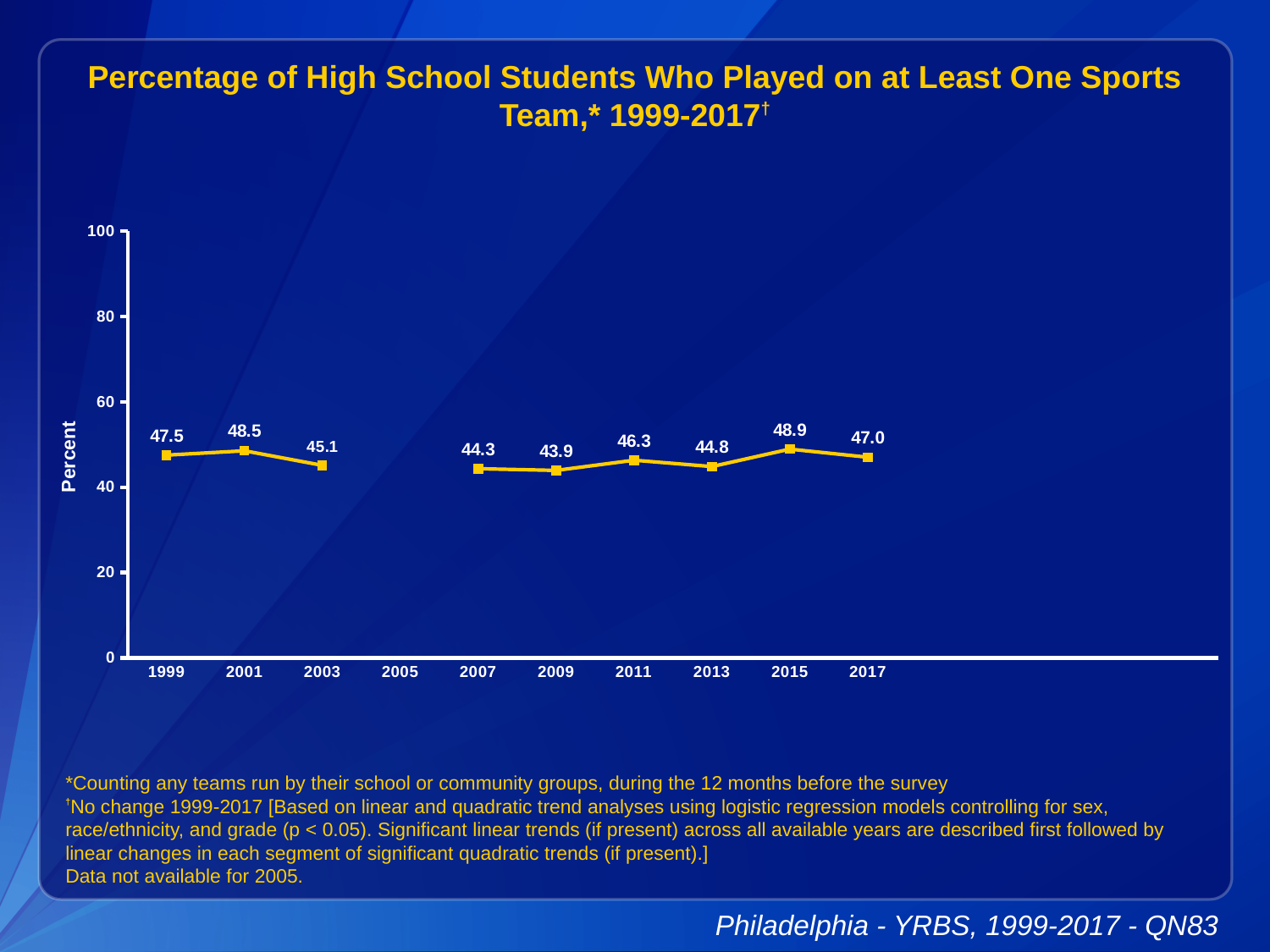
What kind of chart is shown? line chart Which is larger, the value for 2001 or the value for 2003? 2001 How many data points are plotted on the chart? 9 What is the difference between the values for 2015 and 2009? 5.0 Is the value for 2013 greater or less than 60? less Which year has the lowest value? 2009 What is the value for 2009? 43.9 What is the label on the y axis? Percent What is the value for 1999? 47.5 Does the value rise or fall from 2013 to 2015? rise Which year has the highest value? 2015 What is the value for 2017? 47.0